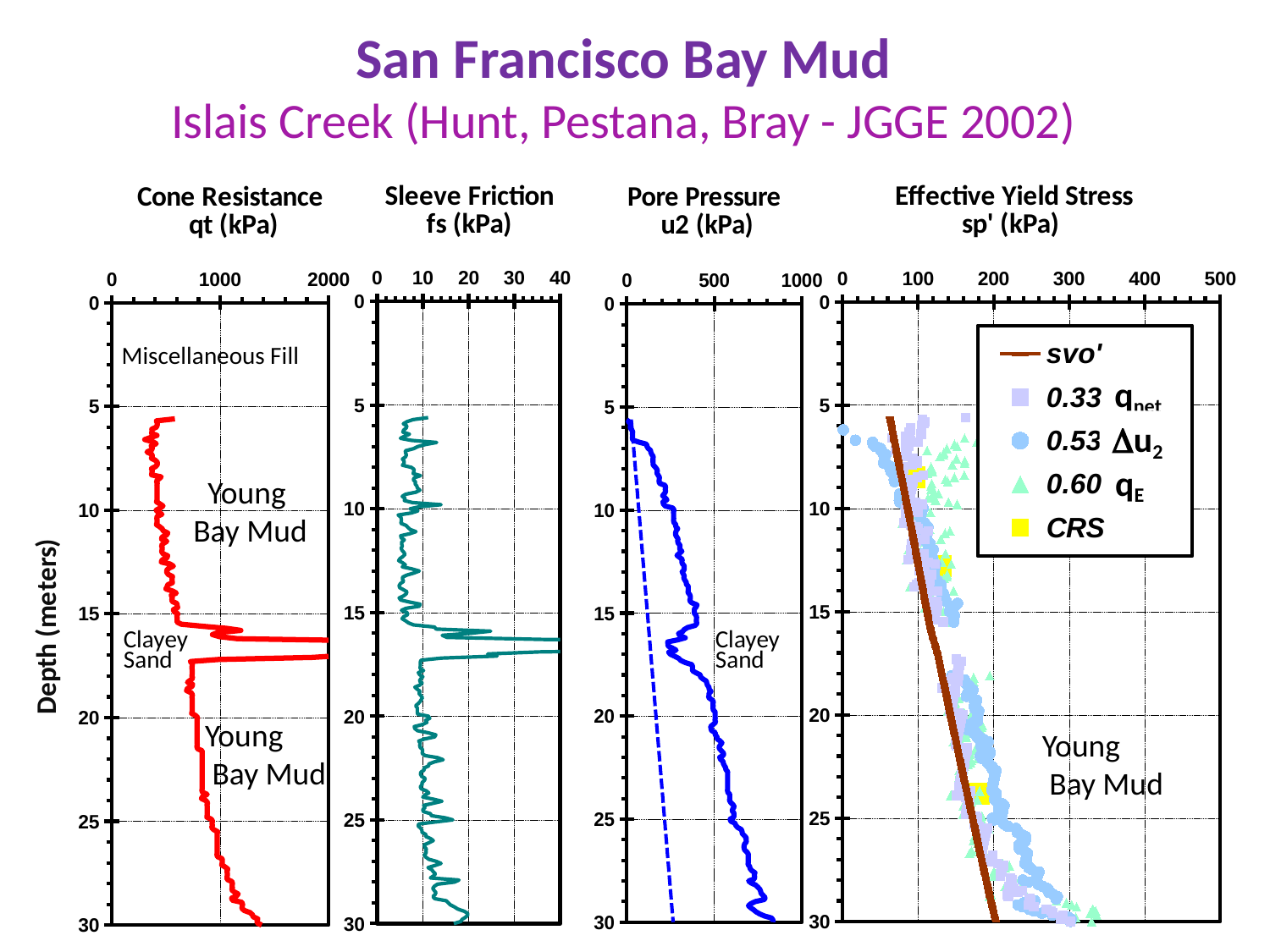
What kind of chart is the Cone Resistance chart? line chart What kind of chart is the Effective Yield Stress chart? scatter chart In the Pore Pressure chart, is the value at a depth of 10 meters greater or less than 500? less In the Sleeve Friction chart, is the value at a depth of 25 meters greater or less than 30? less How many charts are shown on the slide? 4 In the Cone Resistance chart, which is larger: the value at a depth of 10 meters or the value at a depth of 25 meters? 25 meters In the Effective Yield Stress chart, how many series does the legend list? 5 In the Effective Yield Stress chart, what is the first entry listed in the legend? svo' In the Cone Resistance chart, is the value at a depth of 20 meters greater or less than 1000? less In the Pore Pressure chart, does the solid line generally increase or decrease as depth goes from 17 meters to 30 meters? increase